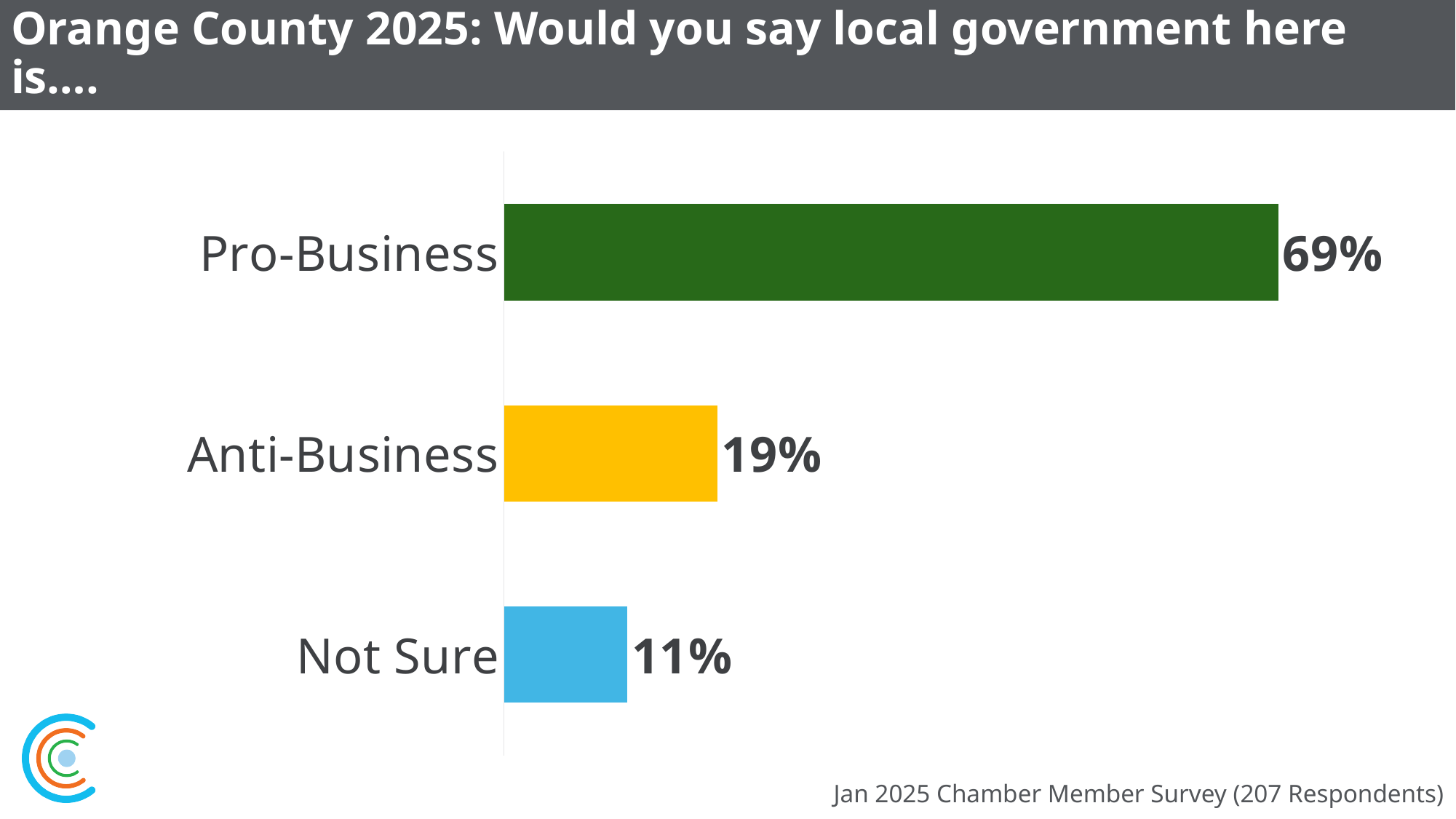
Which is larger, the Anti-Business value or the Not Sure value? Anti-Business According to the source note, how many respondents took part in the survey? 207 What kind of chart is shown on the slide? Bar chart How many response categories are shown in the chart? 3 Which response category has the highest percentage? Pro-Business What percentage of respondents said local government is Pro-Business? 69% What is the difference in percentage points between Pro-Business and Anti-Business? 50 What percentage of respondents said local government is Anti-Business? 19% What percentage of respondents answered Not Sure? 11% What colour is the Pro-Business bar? Green What is the difference in percentage points between Anti-Business and Not Sure? 8 Which response category has the lowest percentage? Not Sure